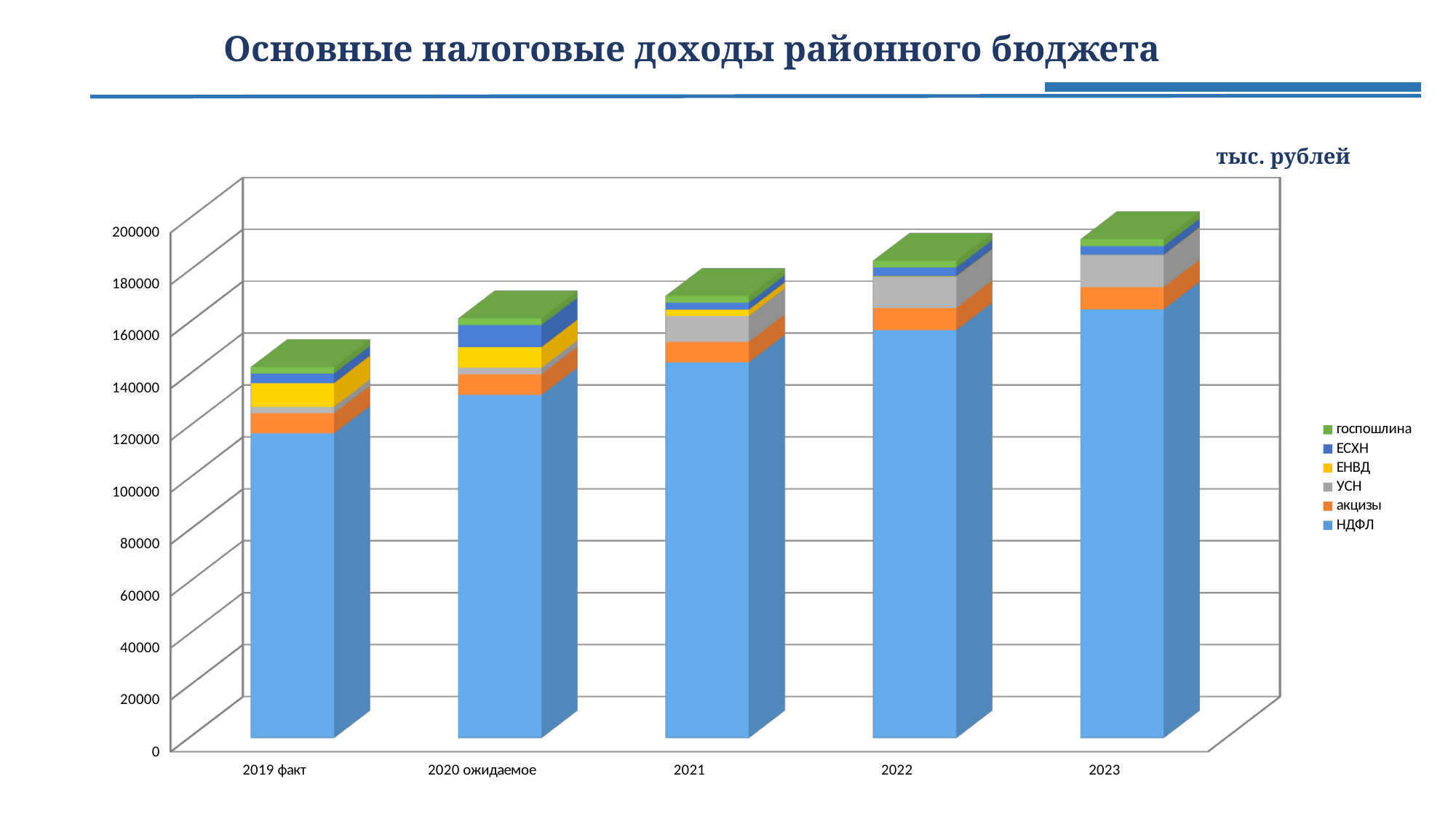
What is the title of the chart on the slide? Основные налоговые доходы районного бюджета Is the total value for 2019 факт greater or less than 160000? less Do the total bar heights rise or fall from 2019 факт to 2023? Rise Which year has the highest total bar? 2023 How many series does the legend list? 6 Is the total value for 2023 greater or less than 180000? greater In what units are the values on the chart given? тыс. рублей How many years (categories) are shown on the x axis? 5 What kind of chart is shown on the slide? Stacked bar chart Which category has the lowest total bar? 2019 факт Is the total value for 2021 greater or less than 160000? greater Which is larger, the НДФЛ segment for 2023 or the НДФЛ segment for 2019 факт? 2023